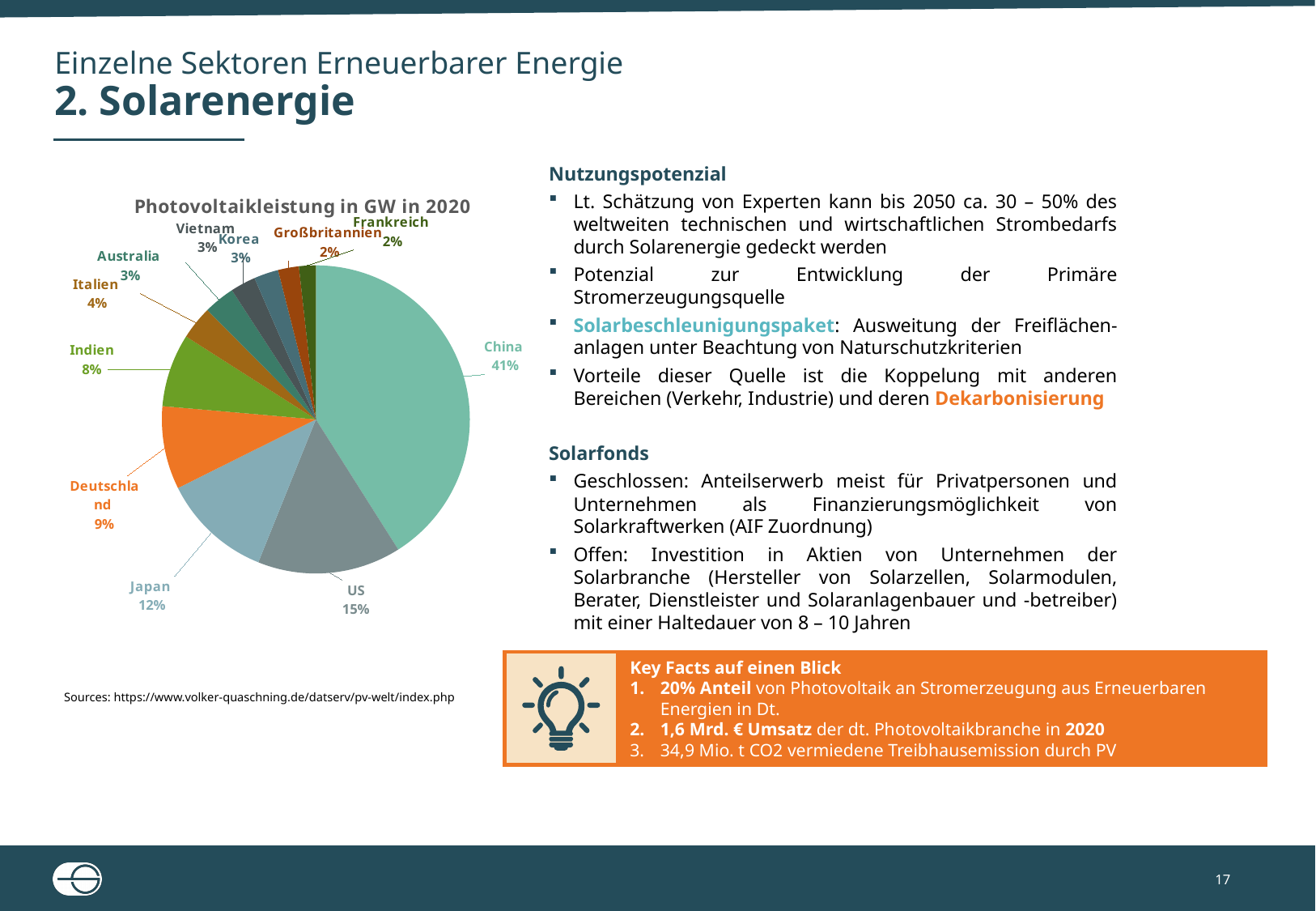
What share of the pie does Deutschland have? 9% Which country has the largest slice of the pie? China What share of the pie does Japan have? 12% What share of the pie does Indien have? 8% What share of the pie does Frankreich have? 2% What share of the pie does Italien have? 4% What share of the pie does China have? 41% Which is larger, the share for Japan or the share for Deutschland? Japan What type of chart is shown on the slide? pie chart What is the title of the chart? Photovoltaikleistung in GW in 2020 How many countries are shown in the pie chart? 11 What is the difference in percentage points between China and US? 26